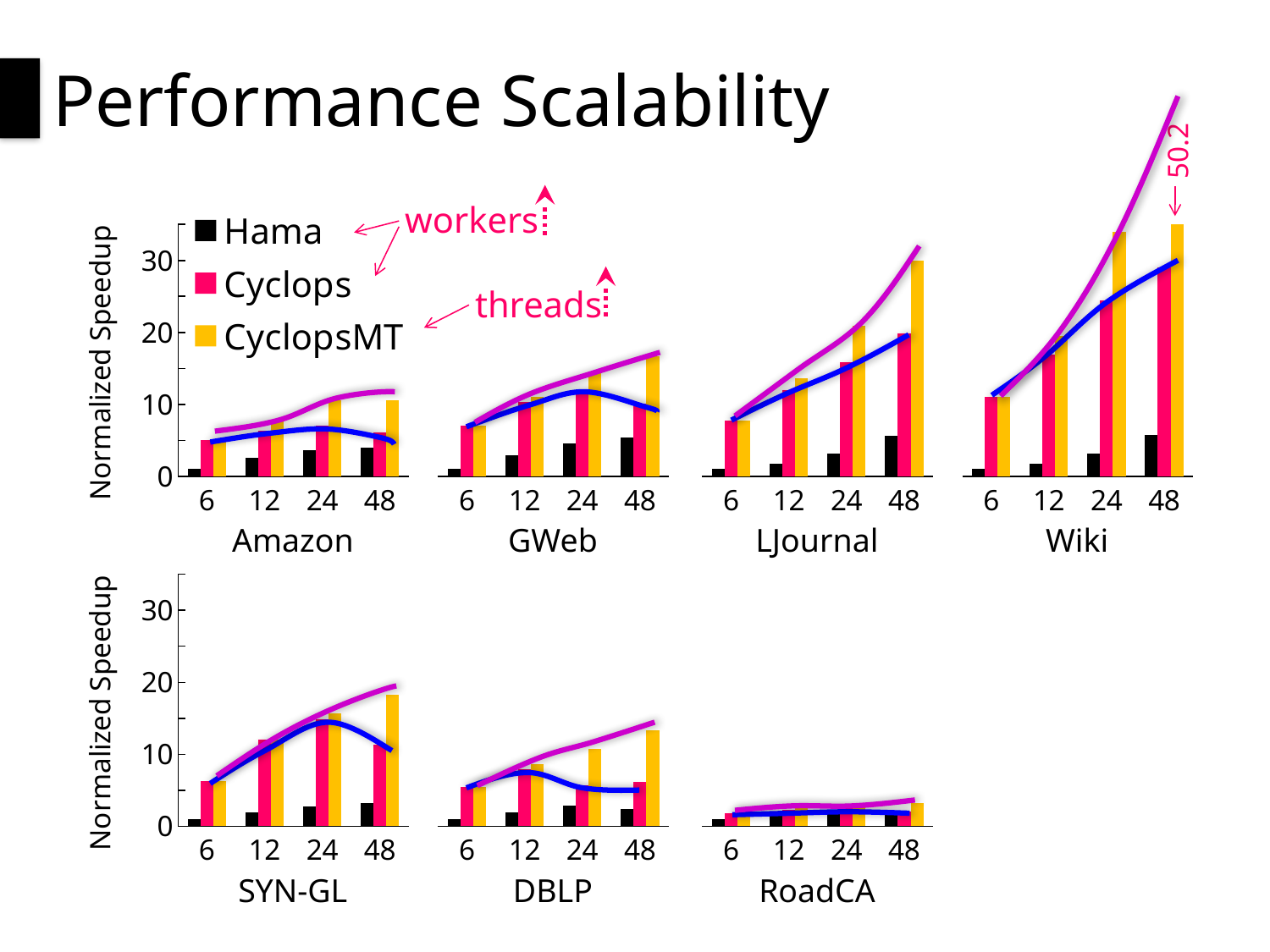
What is the label on the y axis of the charts? Normalized Speedup In the RoadCA chart, is the value for CyclopsMT at 48 workers greater or less than 10? less In the Wiki chart, which is larger at 48 workers, Cyclops or CyclopsMT? CyclopsMT In the Wiki chart, what is the value for CyclopsMT at 48 workers? 50.2 In the Wiki chart, which worker count has the highest CyclopsMT value? 48 What kind of chart is the Amazon chart? bar chart How many charts are shown on the slide? 7 How many series does the legend list? 3 In the Wiki chart, which series has the lowest value at 48 workers? Hama In the Wiki chart, is the value for CyclopsMT at 24 workers greater or less than 30? greater How many worker counts are shown on the x axis of the GWeb chart? 4 In the LJournal chart, do the CyclopsMT values rise or fall as the number of workers increases? rise